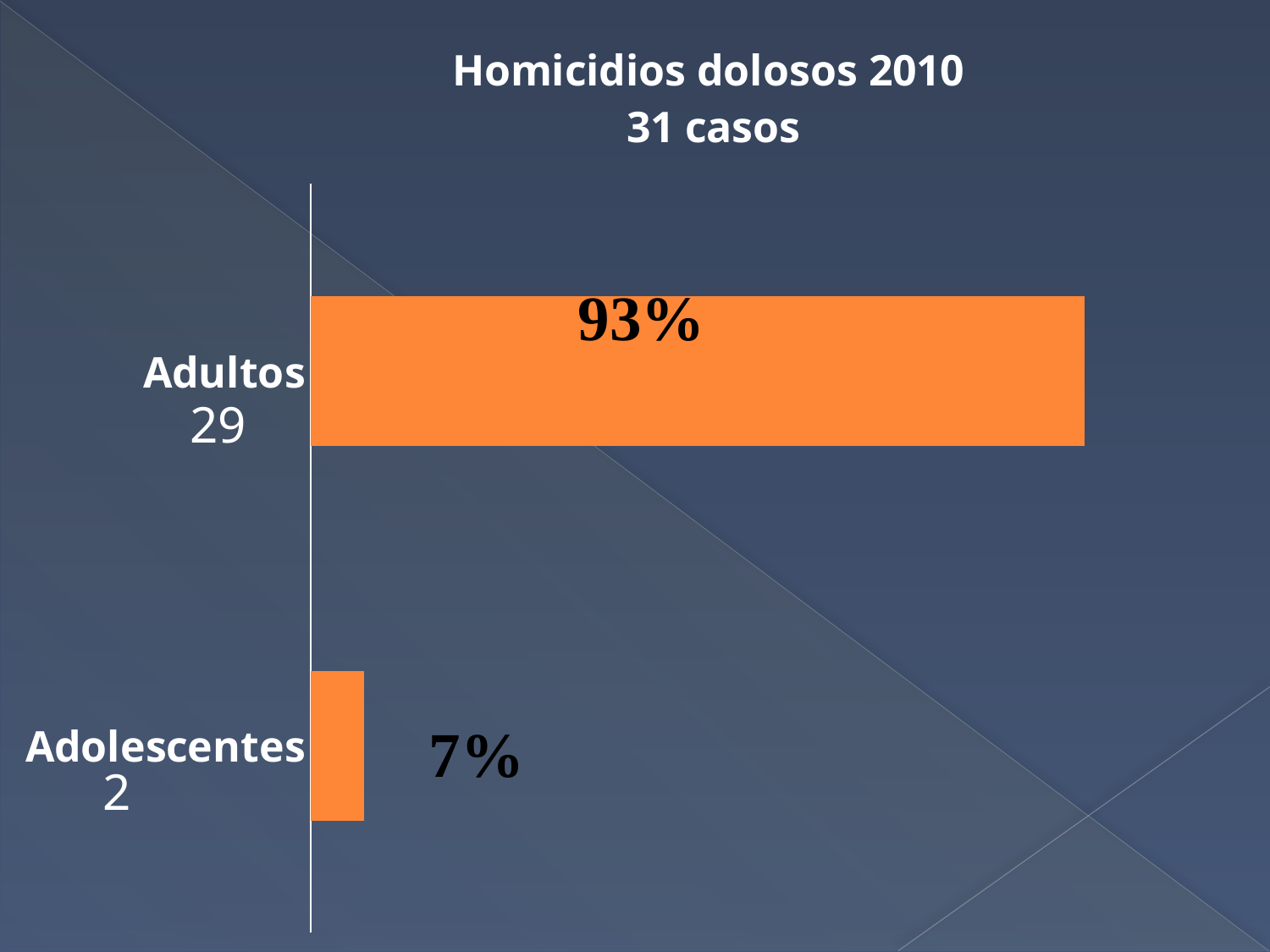
How many cases are listed under the Adultos label? 29 What colour are the bars in the chart? Orange What kind of chart is shown on the slide? Bar chart What is the difference in percentage points between Adultos and Adolescentes? 86 What percentage is shown for Adolescentes? 7% How many cases are listed under the Adolescentes label? 2 How many categories does the chart show? 2 Which is larger, the value for Adultos or the value for Adolescentes? Adultos What percentage is shown for Adultos? 93% Which category has the lowest percentage? Adolescentes What is the title of the chart? Homicidios dolosos 2010 31 casos Which category has the highest percentage? Adultos